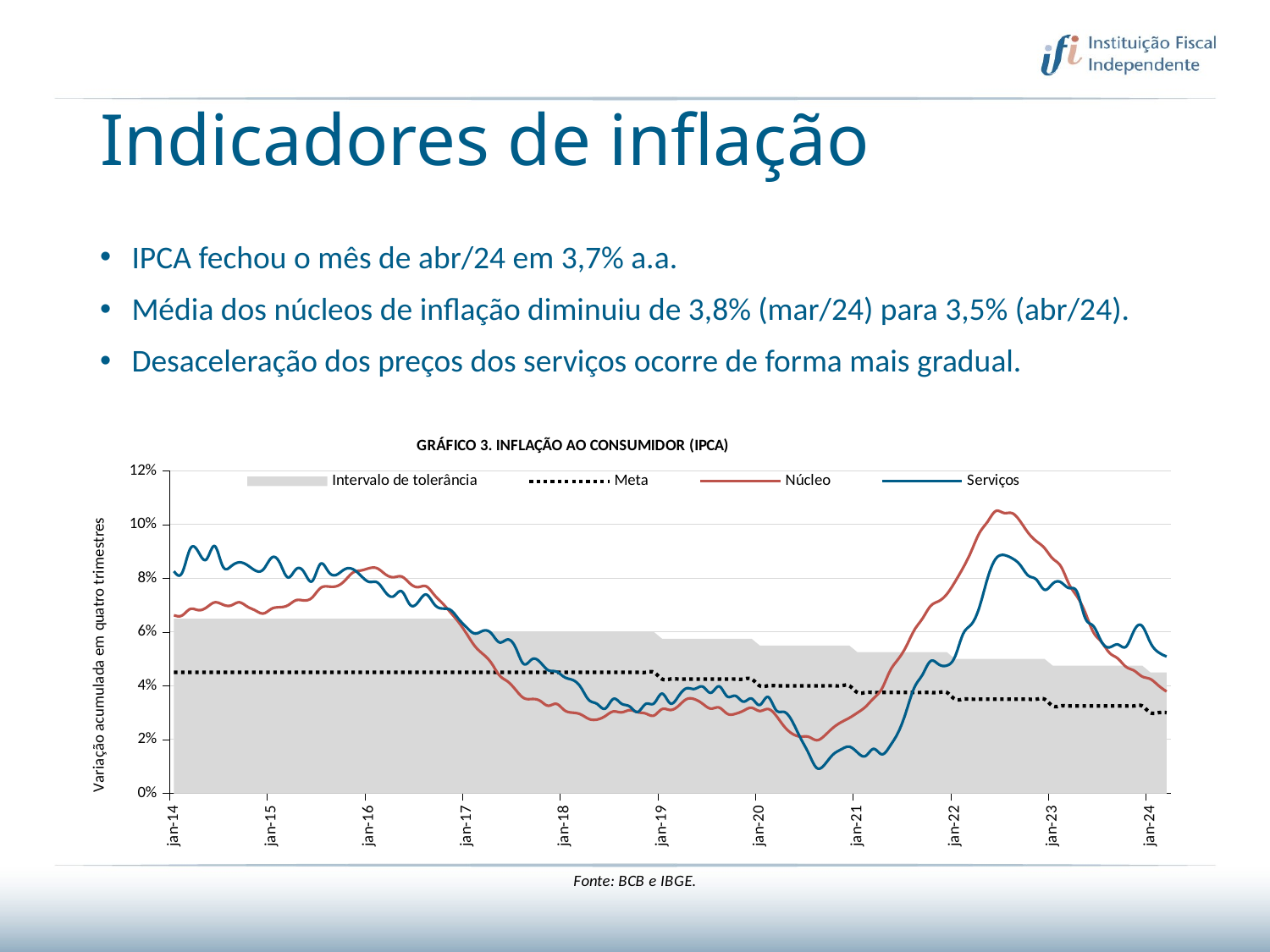
Is the Meta value at jan-24 greater or less than 4%? less Does the Meta series rise or fall from jan-14 to jan-24? fall What is the title of the chart on the slide? GRÁFICO 3. INFLAÇÃO AO CONSUMIDOR (IPCA) How many year labels are shown on the x axis of the chart? 11 How many entries does the legend of Gráfico 3 list? 4 Is the peak value of the Núcleo series greater or less than 10%? greater Which series reaches the highest value anywhere on the chart, Núcleo or Serviços? Núcleo Is the Serviços value at jan-24 greater or less than 4%? greater What is the label of the vertical axis of the chart? Variação acumulada em quatro trimestres What kind of chart is Gráfico 3 on the slide? line chart At jan-22, which series is higher, Núcleo or Serviços? Núcleo